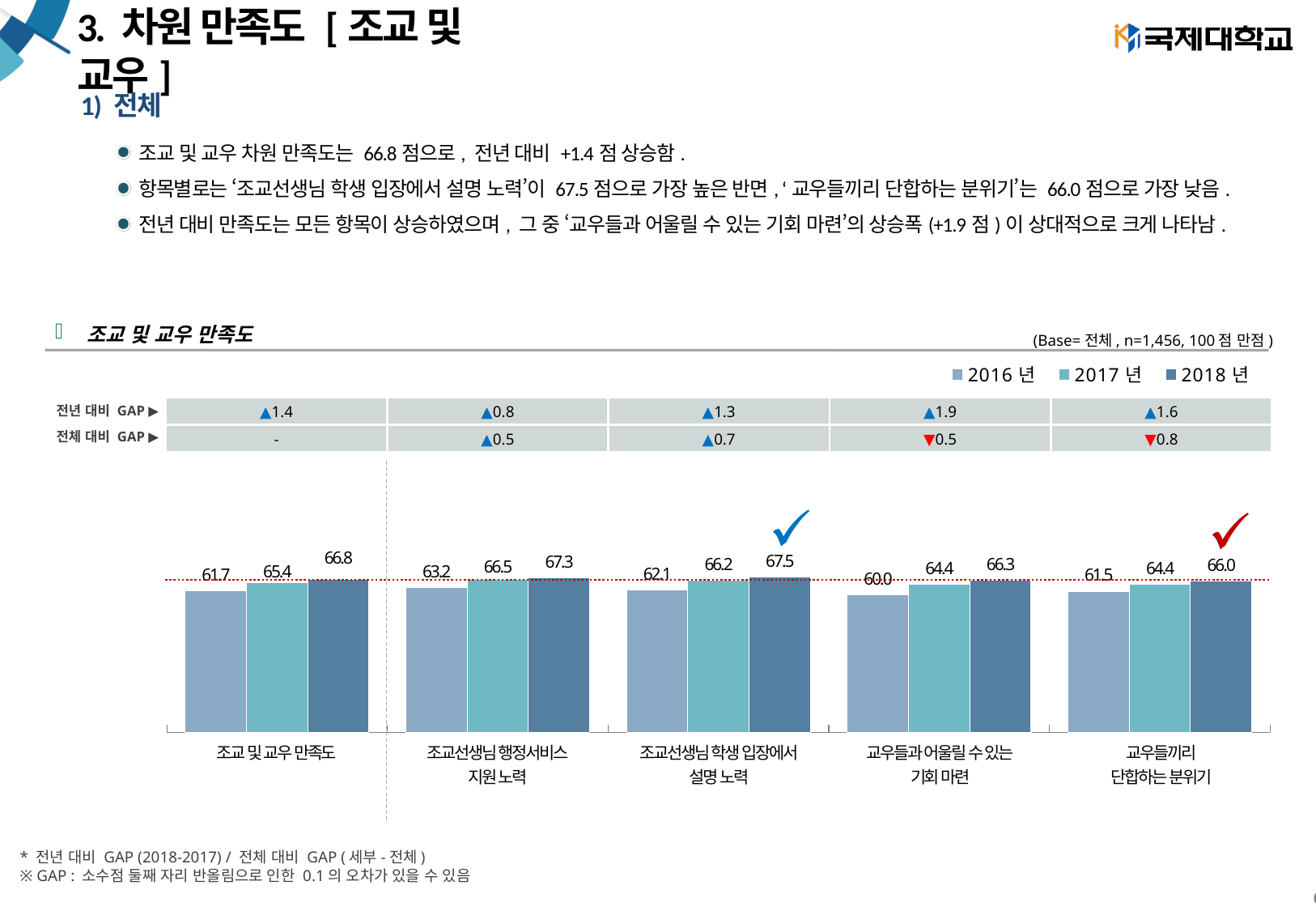
What is the 2018년 value for 조교 및 교우 만족도? 66.8 How many series does the chart legend list? 3 What is the title of the chart? 조교 및 교우 만족도 Do the values for 조교 및 교우 만족도 rise or fall from 2016년 to 2018년? rise What is the difference between the 2018년 and 2017년 values for 교우들과 어울릴 수 있는 기회 마련? 1.9 What is the 2017년 value for 조교선생님 행정서비스 지원 노력? 66.5 What type of chart is shown on the slide? bar chart How many categories are shown along the x axis of the chart? 5 Which category has the highest 2018년 value? 조교선생님 학생 입장에서 설명 노력 Which is larger, the 2018년 value for 조교선생님 행정서비스 지원 노력 or the 2018년 value for 교우들끼리 단합하는 분위기? 조교선생님 행정서비스 지원 노력 What is the 2016년 value for 교우들과 어울릴 수 있는 기회 마련? 60.0 Which category has the lowest 2016년 value? 교우들과 어울릴 수 있는 기회 마련